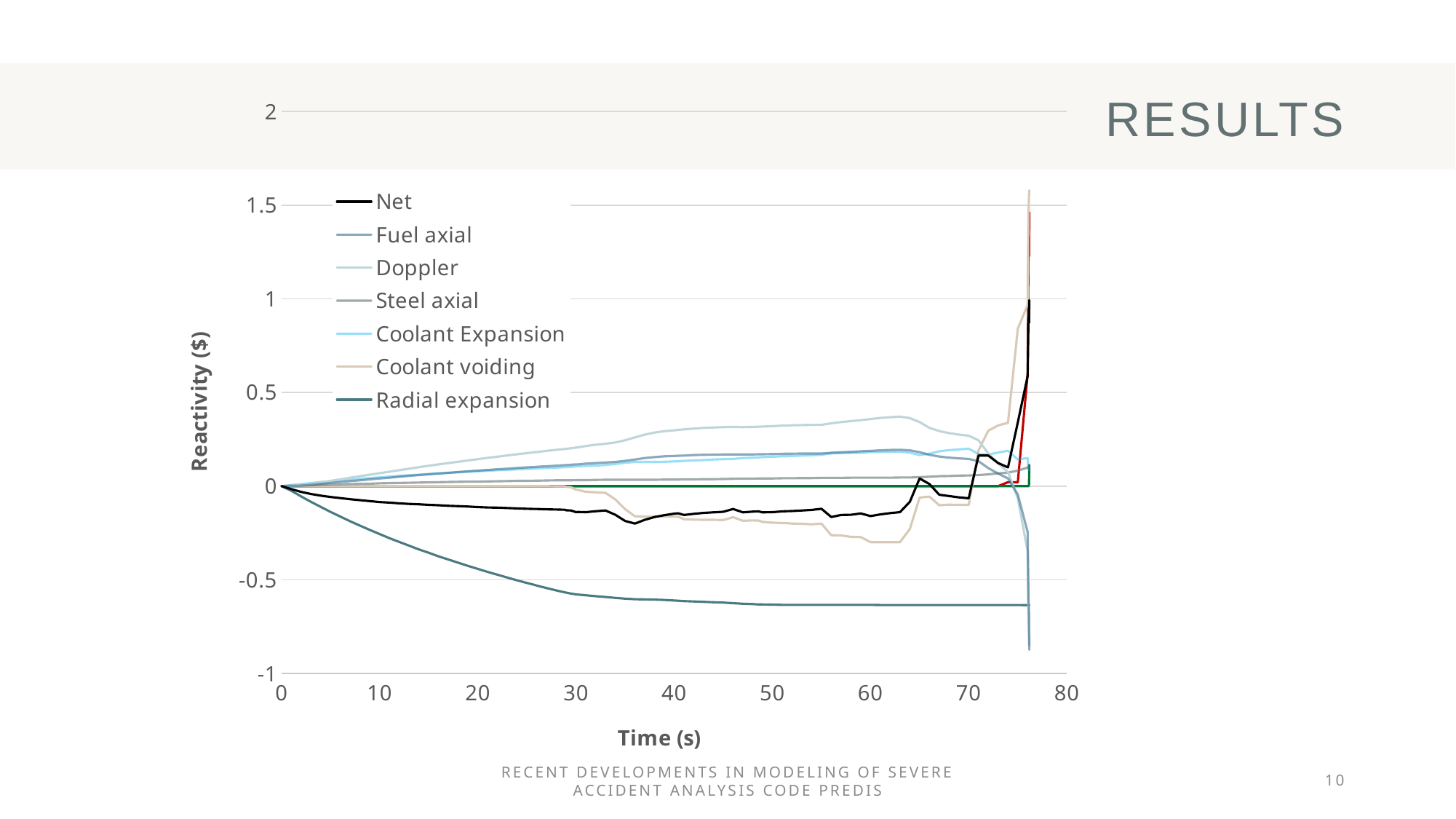
How many series does the legend list? 7 Is the value for Doppler at 60 s greater or less than 0.5? less What is the label of the x axis? Time (s) Is the value for Radial expansion at 50 s greater or less than -0.5? less Which series has the highest value at 60 s? Doppler Does the Radial expansion series rise or fall between 0 s and 30 s? fall Is the value for Doppler at 60 s greater or less than 0? greater What is the label of the y axis? Reactivity ($) Which series has the lowest value at 50 s? Radial expansion What kind of chart is shown on the slide? line chart